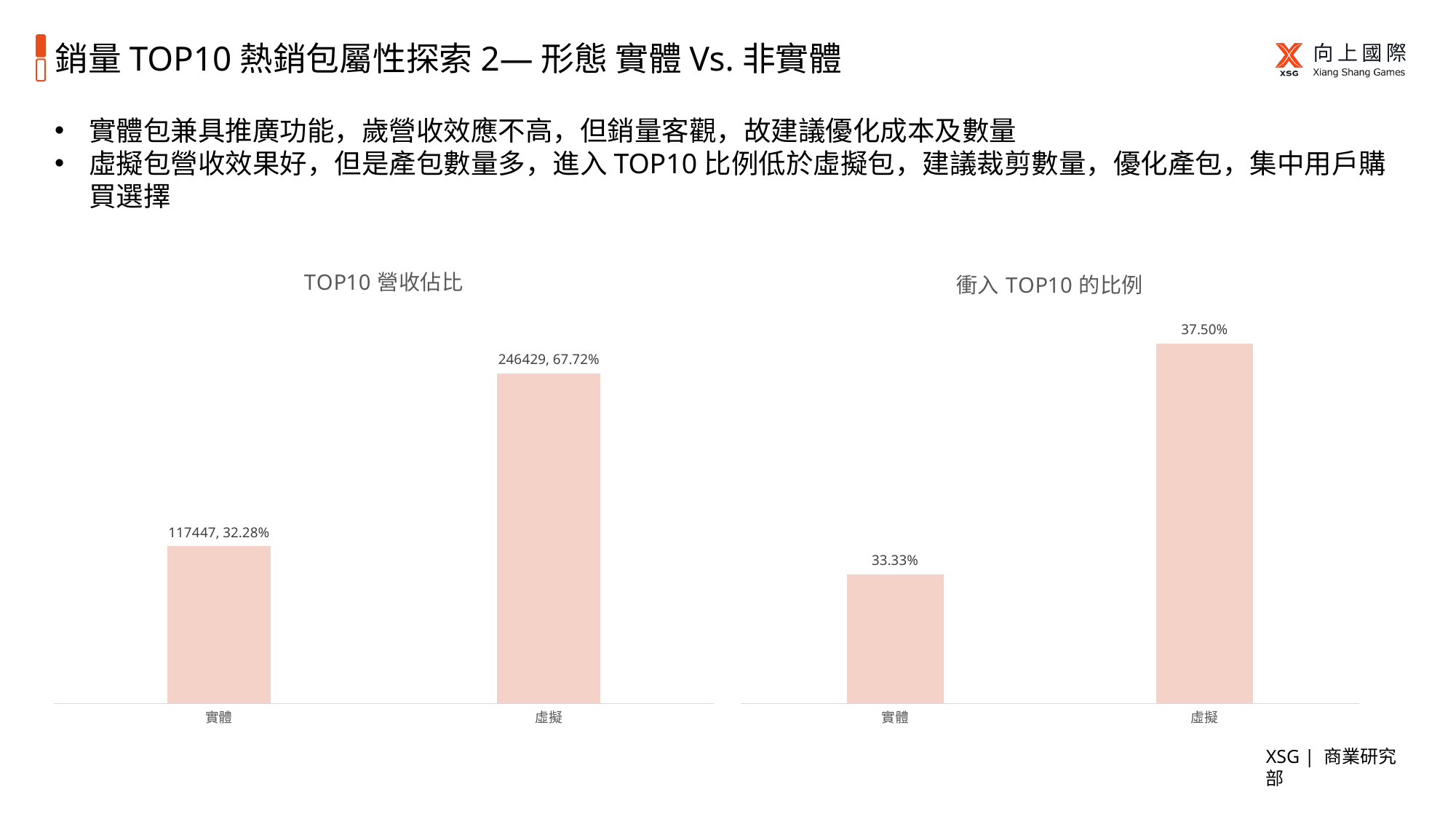
In the "衝入 TOP10 的比例" chart, is the value for 虛擬 larger or smaller than the value for 實體? larger How many categories are shown in the "TOP10 營收佔比" chart? 2 In the "衝入 TOP10 的比例" chart, what is the value for 虛擬? 37.50% In the "TOP10 營收佔比" chart, what is the difference in percentage share between 虛擬 and 實體? 35.44% In the "衝入 TOP10 的比例" chart, what is the difference between the values for 虛擬 and 實體? 4.17% What type of chart is the "衝入 TOP10 的比例" chart? bar chart In the "衝入 TOP10 的比例" chart, what is the value for 實體? 33.33% In the "TOP10 營收佔比" chart, what is the data label shown for 虛擬? 246429, 67.72% In the "TOP10 營收佔比" chart, what is the data label shown for 實體? 117447, 32.28% In the "衝入 TOP10 的比例" chart, which category has the lowest value? 實體 In the "TOP10 營收佔比" chart, which category has the higher value? 虛擬 In the "TOP10 營收佔比" chart, what is the difference between the revenue amounts for 虛擬 and 實體? 128982